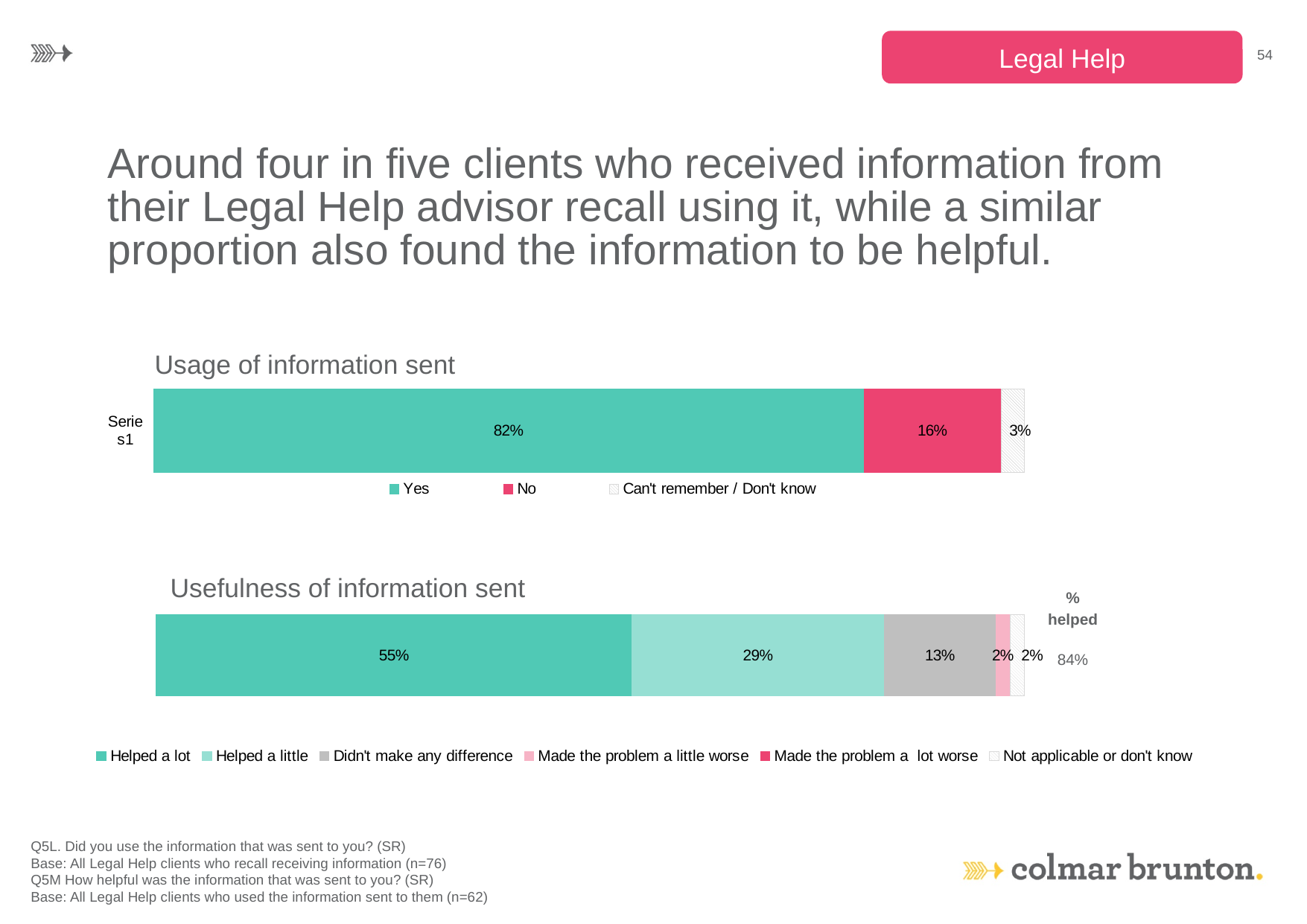
In the 'Usefulness of information sent' chart, what percentage said the information helped a lot? 55% In the 'Usage of information sent' chart, how many series does the legend list? 3 In the 'Usage of information sent' chart, what is the difference in percentage points between Yes and No? 66 percentage points In the 'Usefulness of information sent' chart, what percentage said the information didn't make any difference? 13% In the 'Usage of information sent' chart, what percentage of clients answered No? 16% In the 'Usage of information sent' chart, what percentage of clients answered Can't remember / Don't know? 3% In the 'Usefulness of information sent' chart, what percentage said the information helped a little? 29% In the 'Usage of information sent' chart, what percentage of clients answered Yes? 82% What kind of chart is the 'Usage of information sent' chart? Stacked bar chart In the 'Usage of information sent' chart, which response has the largest share? Yes In the 'Usefulness of information sent' chart, how many series does the legend list? 6 In the 'Usefulness of information sent' chart, what is the combined '% helped' figure shown to the right of the bar? 84%